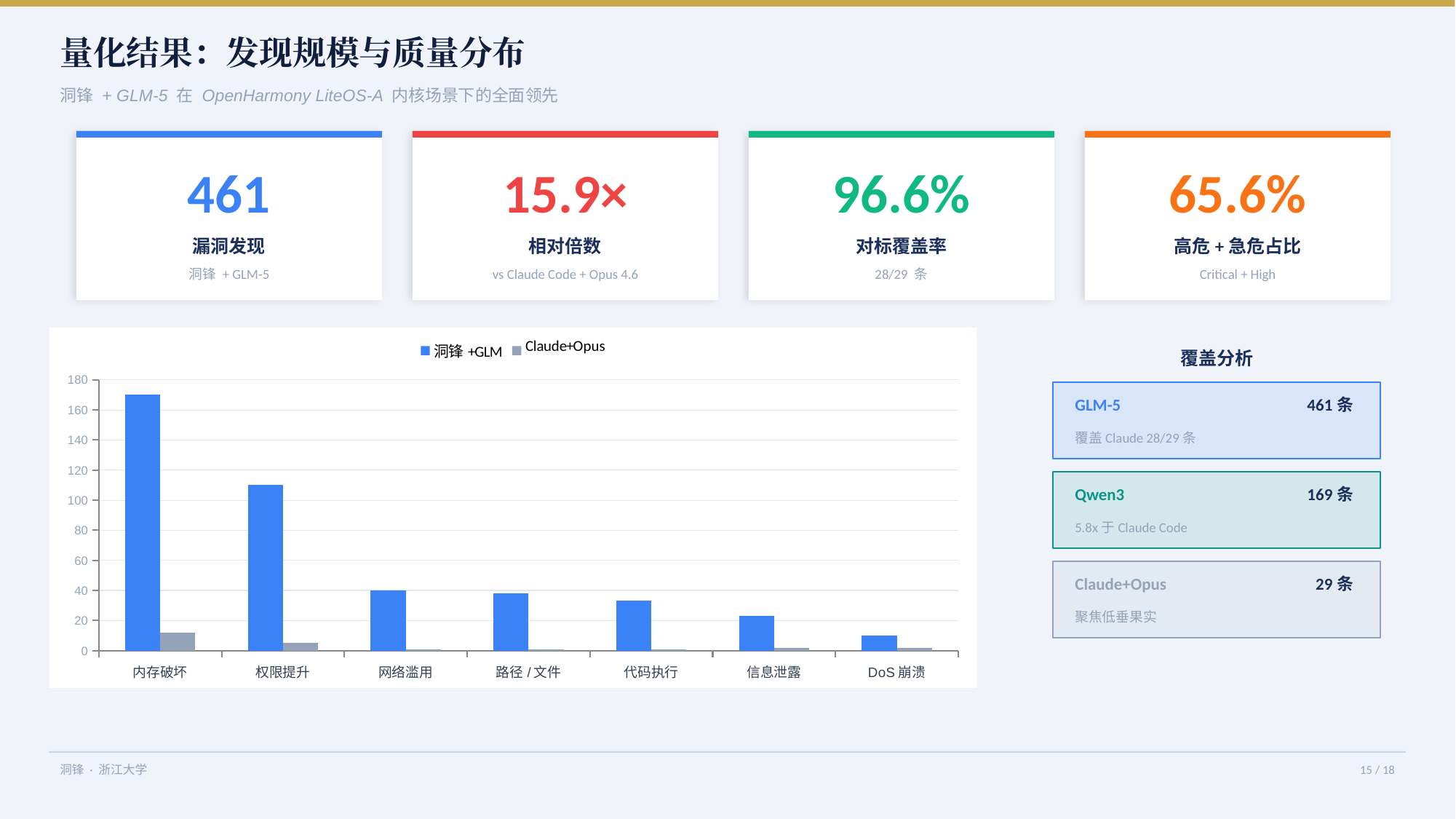
For 内存破坏, which series has the larger value: 洞锋 +GLM or Claude+Opus? 洞锋 +GLM For the 洞锋 +GLM series, which is larger: 权限提升 or 网络滥用? 权限提升 How many categories are shown on the x axis of the bar chart? 7 Is the 洞锋 +GLM value for 权限提升 greater or less than 100? greater Is the 洞锋 +GLM value for 内存破坏 greater or less than 160? greater Which category has the lowest value for the 洞锋 +GLM series? DoS 崩溃 How many series does the legend of the bar chart list? 2 Do the 洞锋 +GLM values rise or fall from left to right along the x axis? fall Which category has the highest value for the 洞锋 +GLM series? 内存破坏 Is the 洞锋 +GLM value for 信息泄露 greater or less than 40? less What kind of chart is shown on the slide? bar chart